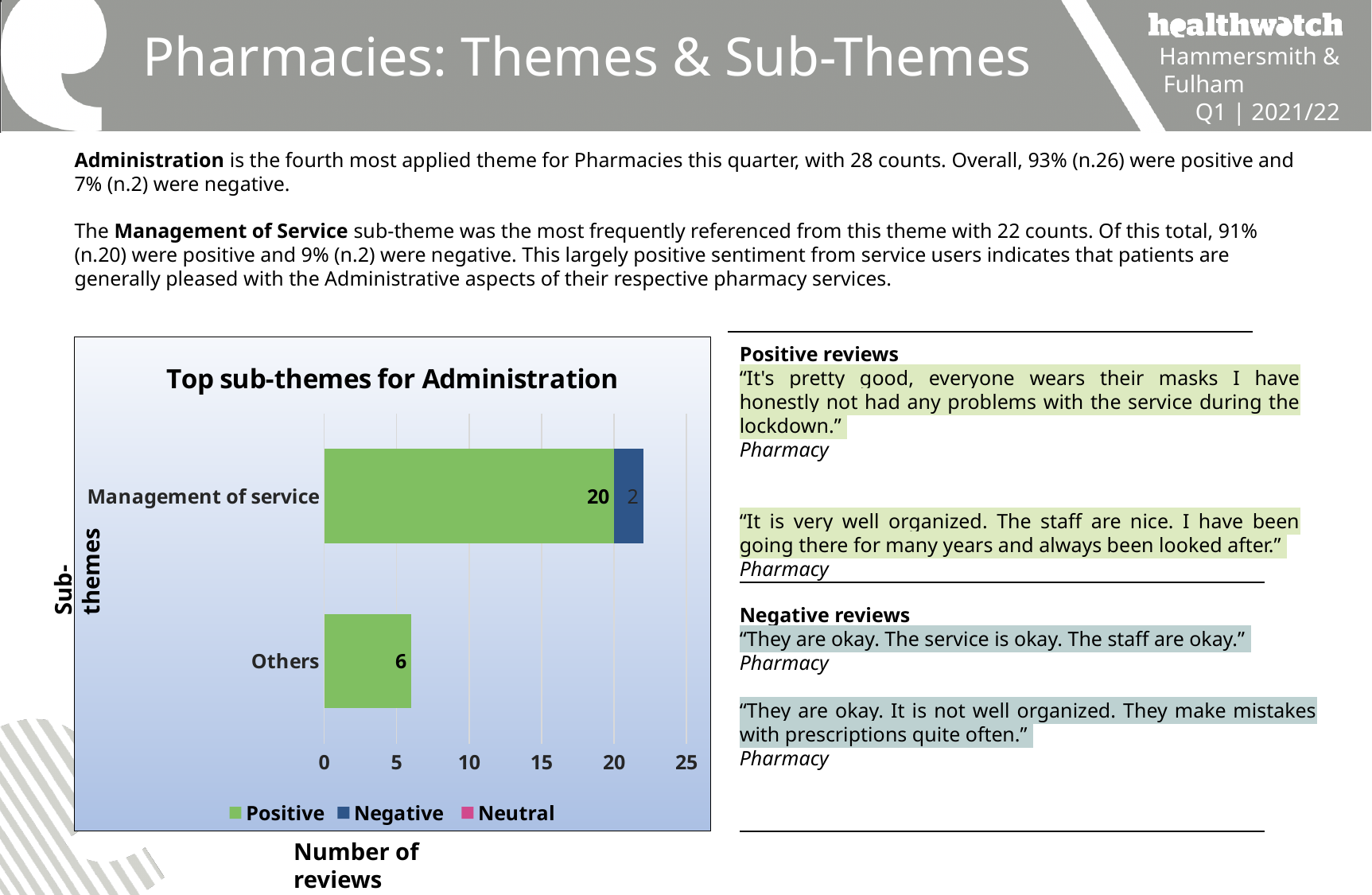
What is the total of the stacked bar for Management of service? 22 Which is larger: the Positive value for Management of service or the Positive value for Others? Management of service Which sub-theme has the highest Positive value? Management of service How many sub-themes are shown on the chart? 2 What kind of chart is shown? Stacked bar chart How many series does the legend list? 3 Which sub-theme has the lowest Positive value? Others What is the Positive value for Others? 6 What is the Positive value for Management of service? 20 What is the Negative value for Management of service? 2 What is the difference between the Positive values for Management of service and Others? 14 What is the title of the chart? Top sub-themes for Administration